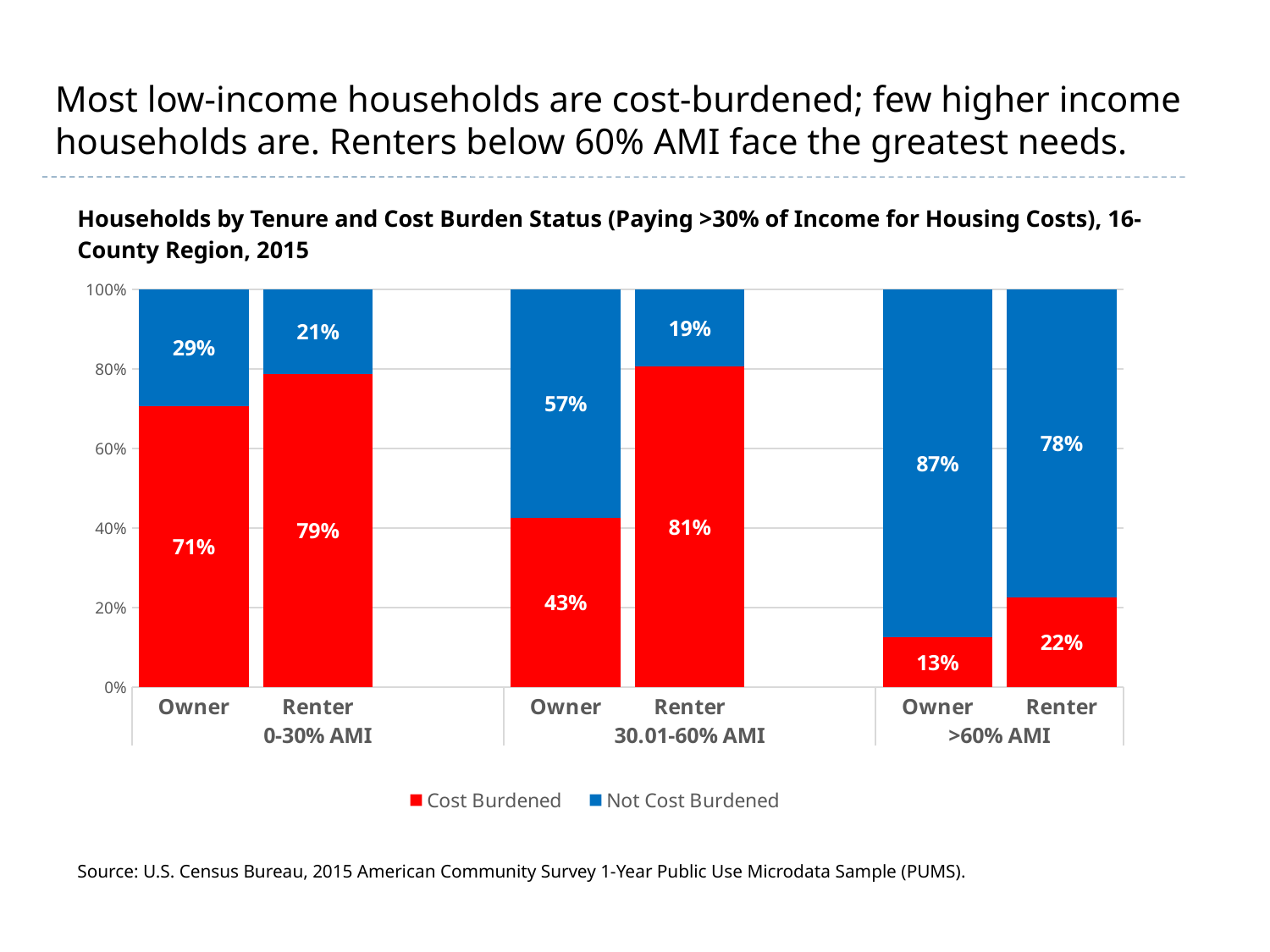
What percentage of Owner households in the >60% AMI group are Not Cost Burdened? 87% How many bars are plotted in the chart? 6 Which bar has the highest Cost Burdened share? Renter, 30.01-60% AMI Which is larger: the Cost Burdened share for Owners in the 30.01-60% AMI group or for Renters in the >60% AMI group? Owners in the 30.01-60% AMI group What is the difference in Cost Burdened share between Renter and Owner households in the 0-30% AMI group? 8 percentage points What is the total of the Cost Burdened and Not Cost Burdened shares for Renters in the 30.01-60% AMI group? 100% What percentage of Renter households in the 0-30% AMI group are Cost Burdened? 79% How many series does the legend list? 2 What kind of chart is shown on the slide? Stacked bar chart What percentage of Owner households in the 30.01-60% AMI group are Cost Burdened? 43% Which bar has the lowest Cost Burdened share? Owner, >60% AMI Which colour represents the Cost Burdened series in the chart? Red